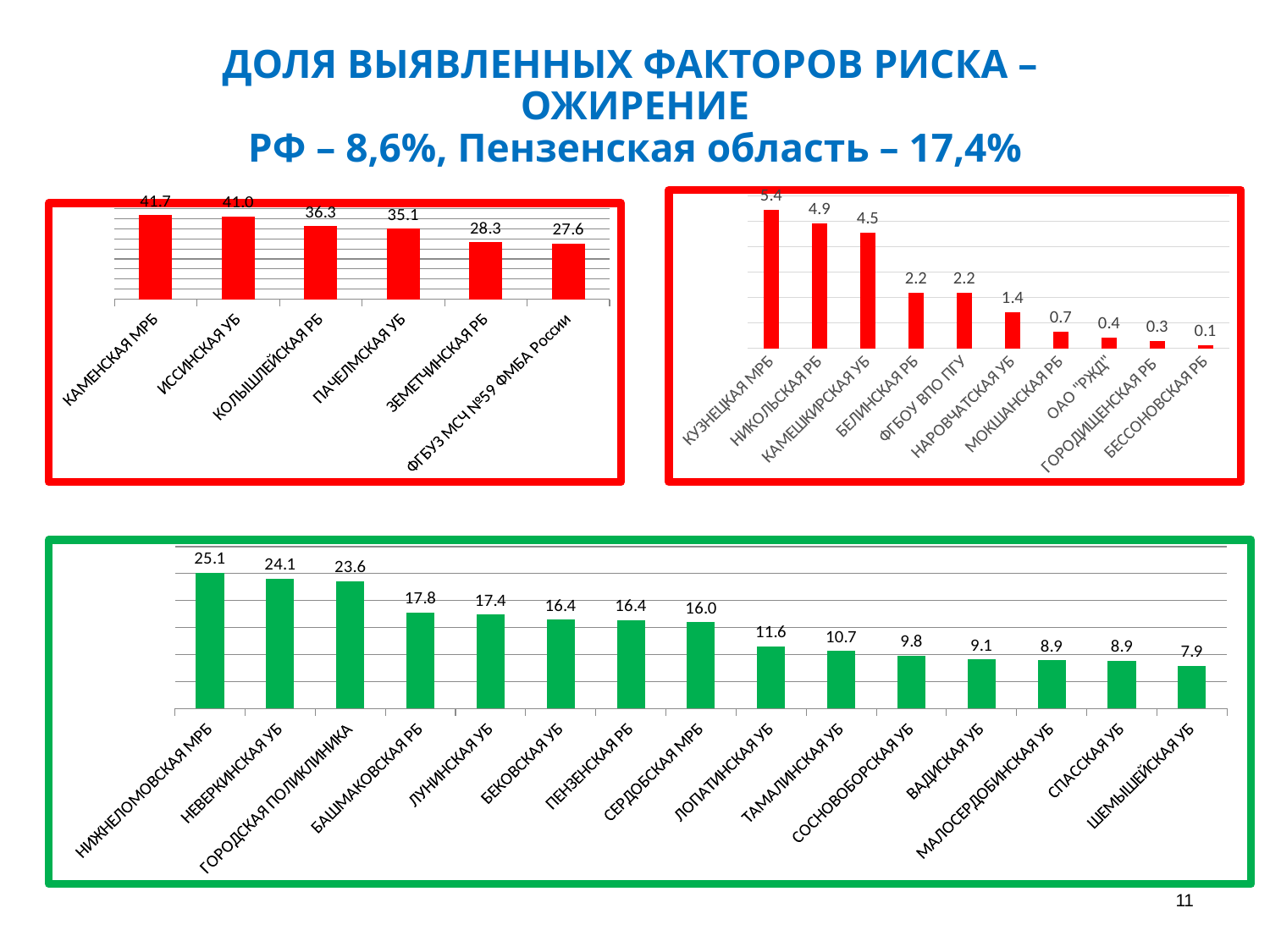
In the bottom chart, what is the value for ЛОПАТИНСКАЯ УБ? 11.6 In the top-left chart, which category has the highest value? КАМЕНСКАЯ МРБ In the bottom chart, which is larger, the value for БАШМАКОВСКАЯ РБ or the value for СЕРДОБСКАЯ МРБ? БАШМАКОВСКАЯ РБ In the top-right chart, which category has the lowest value? БЕССОНОВСКАЯ РБ In the top-left chart, what is the difference between the values for КАМЕНСКАЯ МРБ and ФГБУЗ МСЧ №59 ФМБА России? 14.1 How many categories are shown in the top-right chart? 10 How many categories are shown in the bottom chart? 15 In the top-left chart, what is the value for КОЛЫШЛЕЙСКАЯ РБ? 36.3 How many categories are shown in the top-left chart? 6 What type of chart is the bottom chart? bar chart In the top-right chart, do the values rise or fall from left to right? fall In the top-right chart, what is the value for НАРОВЧАТСКАЯ УБ? 1.4